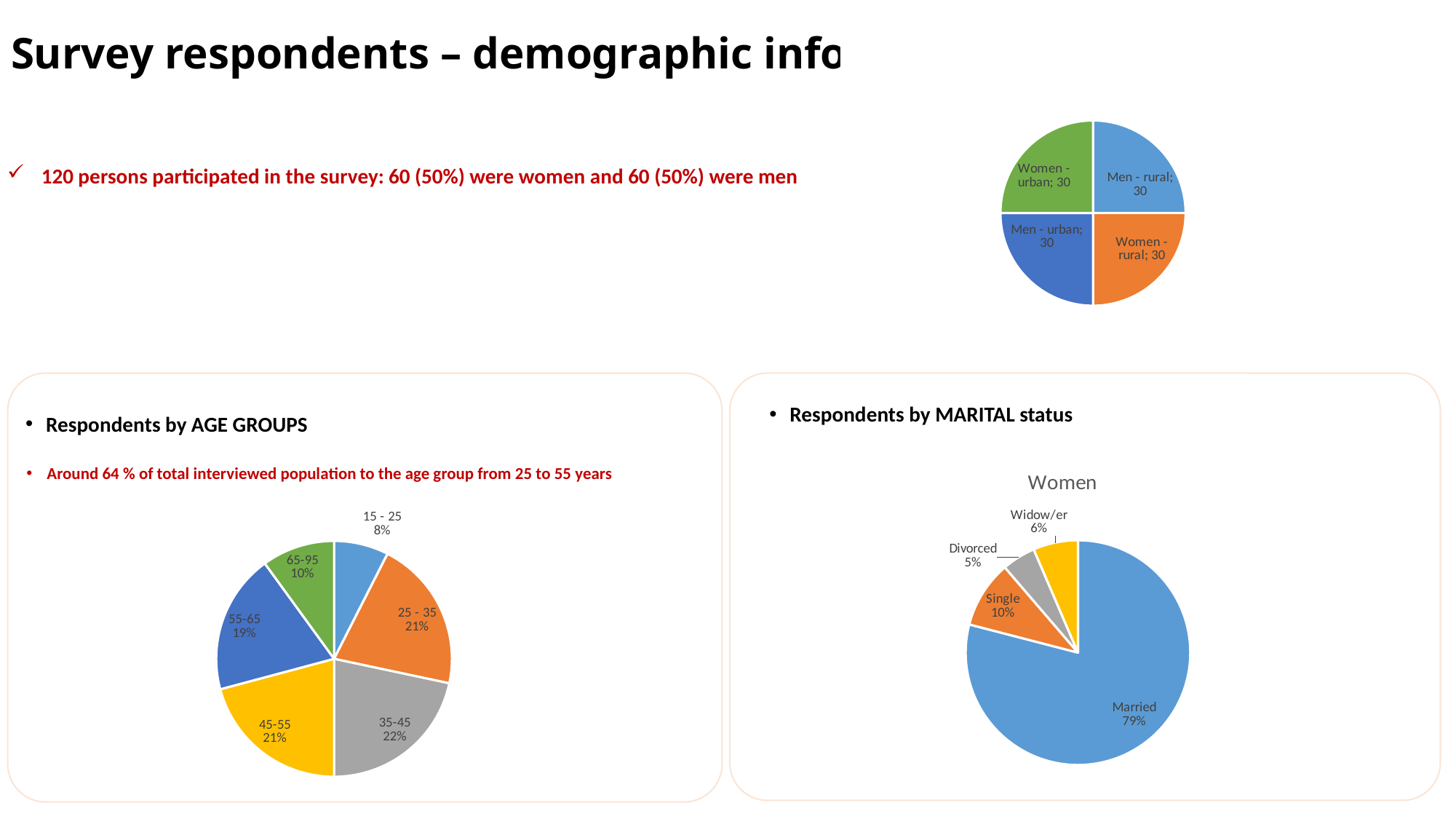
In the top-right pie chart, what is the value for Men - rural? 30 In the age groups pie chart, which age group has the smallest share? 15 - 25 How many age groups are shown in the age groups pie chart? 6 What type of chart is used for the respondents by age groups? Pie chart How many slices does the top-right pie chart have? 4 In the Women marital status pie chart, which category has the smallest share? Divorced In the Women marital status pie chart, what share of respondents are Married? 79% In the Women marital status pie chart, which is larger: Single or Widow/er? Single In the age groups pie chart, what share do respondents aged 35-45 make up? 22% In the age groups pie chart, what is the difference in percentage points between the 55-65 group and the 65-95 group? 9 What is the title of the marital status pie chart in the bottom-right panel? Women In the age groups pie chart, which age group has the largest share? 35-45